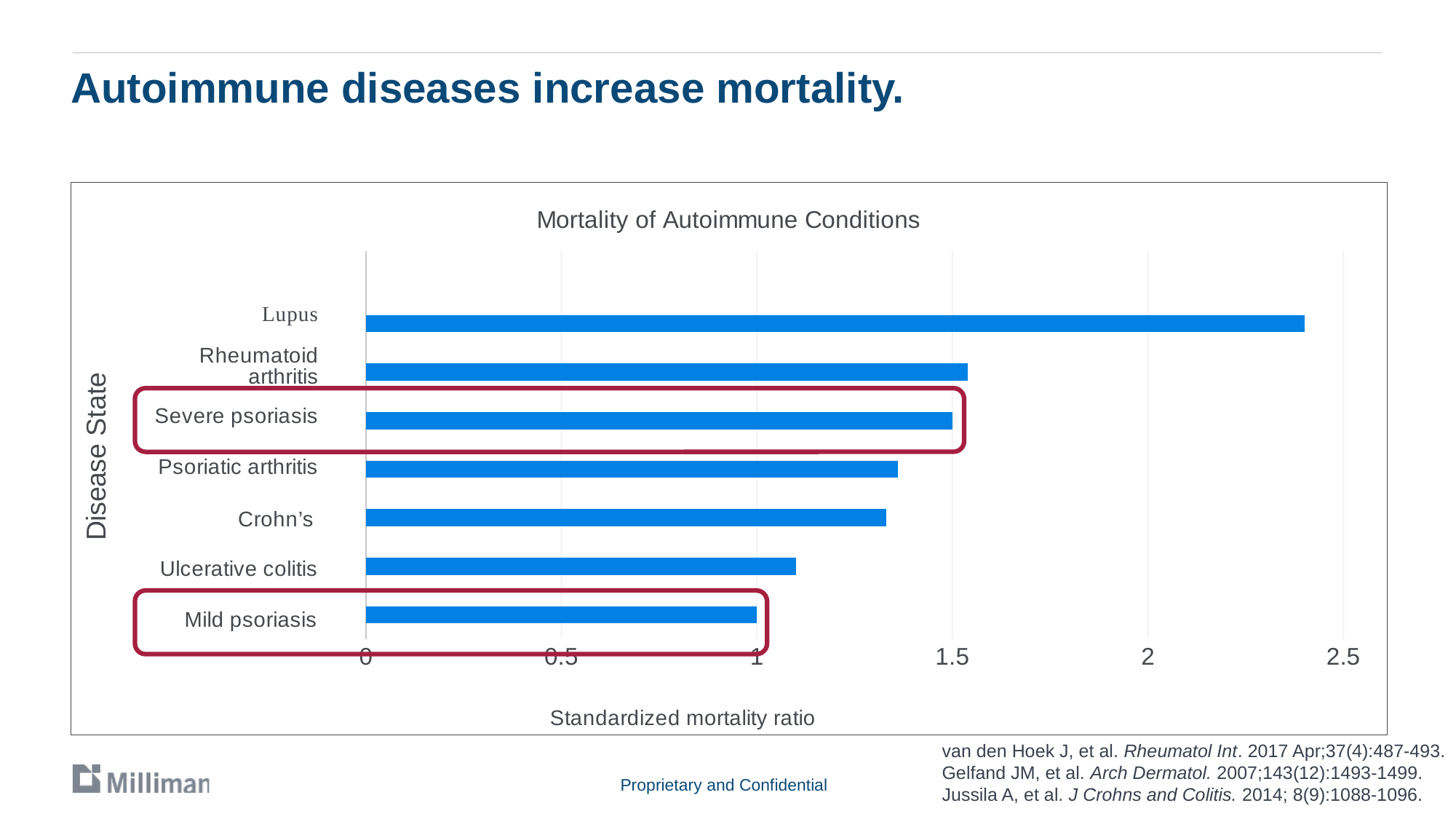
Which has a higher standardized mortality ratio, Psoriatic arthritis or Ulcerative colitis? Psoriatic arthritis Is the standardized mortality ratio for Crohn's greater or less than 1? greater How many disease states are plotted in the chart? 7 Is the standardized mortality ratio for Lupus greater or less than 2? greater Which disease state has the highest standardized mortality ratio? Lupus Is the standardized mortality ratio for Psoriatic arthritis greater or less than 1.5? less What is the label of the horizontal axis of the chart? Standardized mortality ratio Which has a higher standardized mortality ratio, Lupus or Rheumatoid arthritis? Lupus What type of chart is shown on the slide? Bar chart What is the title of the chart? Mortality of Autoimmune Conditions Which disease state has the lowest standardized mortality ratio? Mild psoriasis